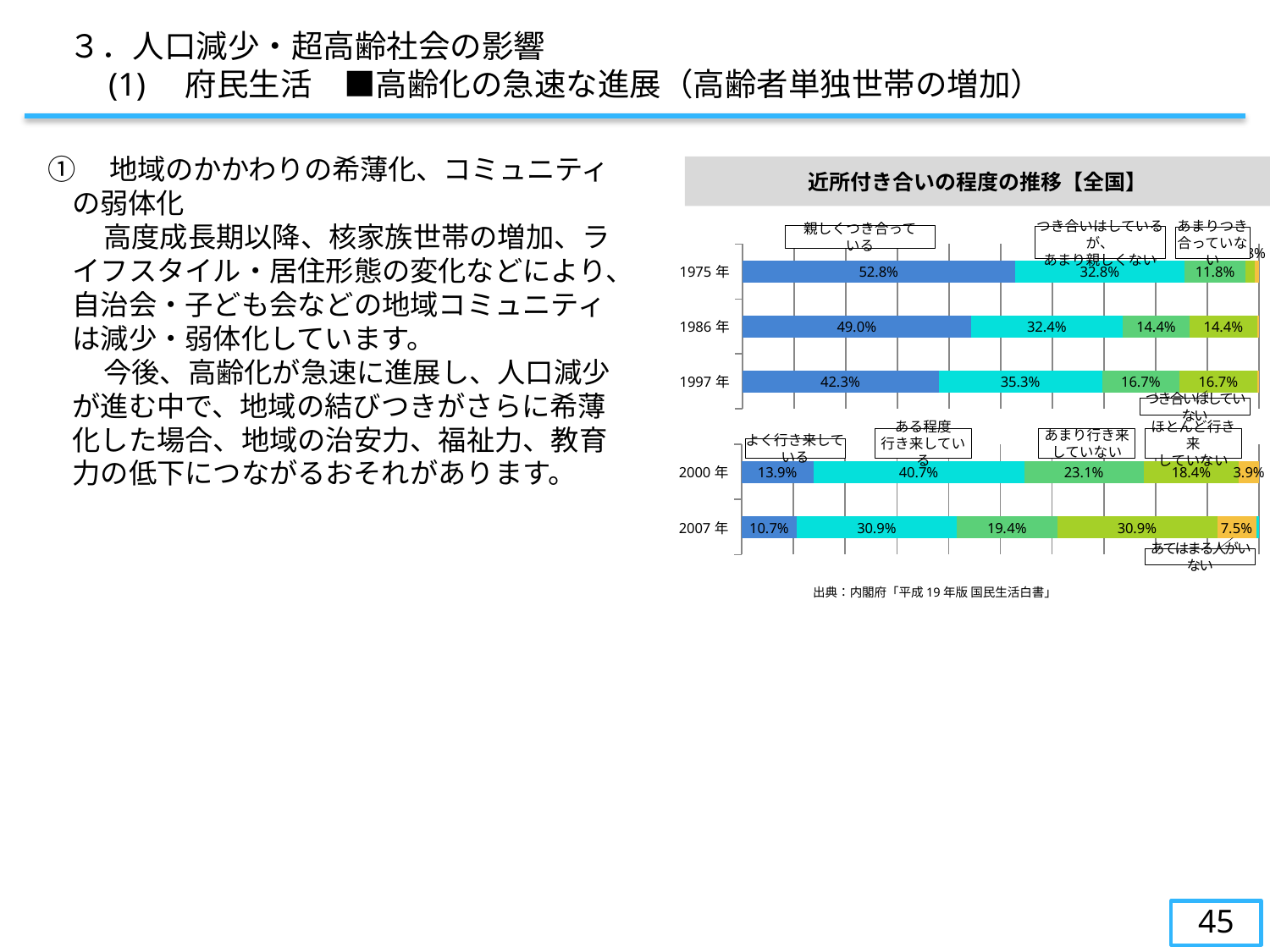
What is the title of the chart on the slide? 近所付き合いの程度の推移【全国】 How many years (bars) are shown in the chart? 5 What kind of chart is shown on the slide? stacked bar chart Does the first (leftmost) segment of each bar rise or fall from 1975 to 2007? fall Which is larger, the あまり行き来していない value for 2000 or for 2007? 2000 (23.1%) What is the value of the よく行き来している segment for 2007? 10.7% What is the value of the つき合いはしているが、あまり親しくない segment for 1997? 35.3% What is the difference between the 親しくつき合っている values for 1975 and 1997? 10.5% Which year has the highest value for the 親しくつき合っている segment among 1975, 1986 and 1997? 1975 年 What is the value of the ある程度行き来している segment for 2000? 40.7% What is the value of the 親しくつき合っている segment for 1975? 52.8% What is the total of all segments in the 2000 bar? 100.0%